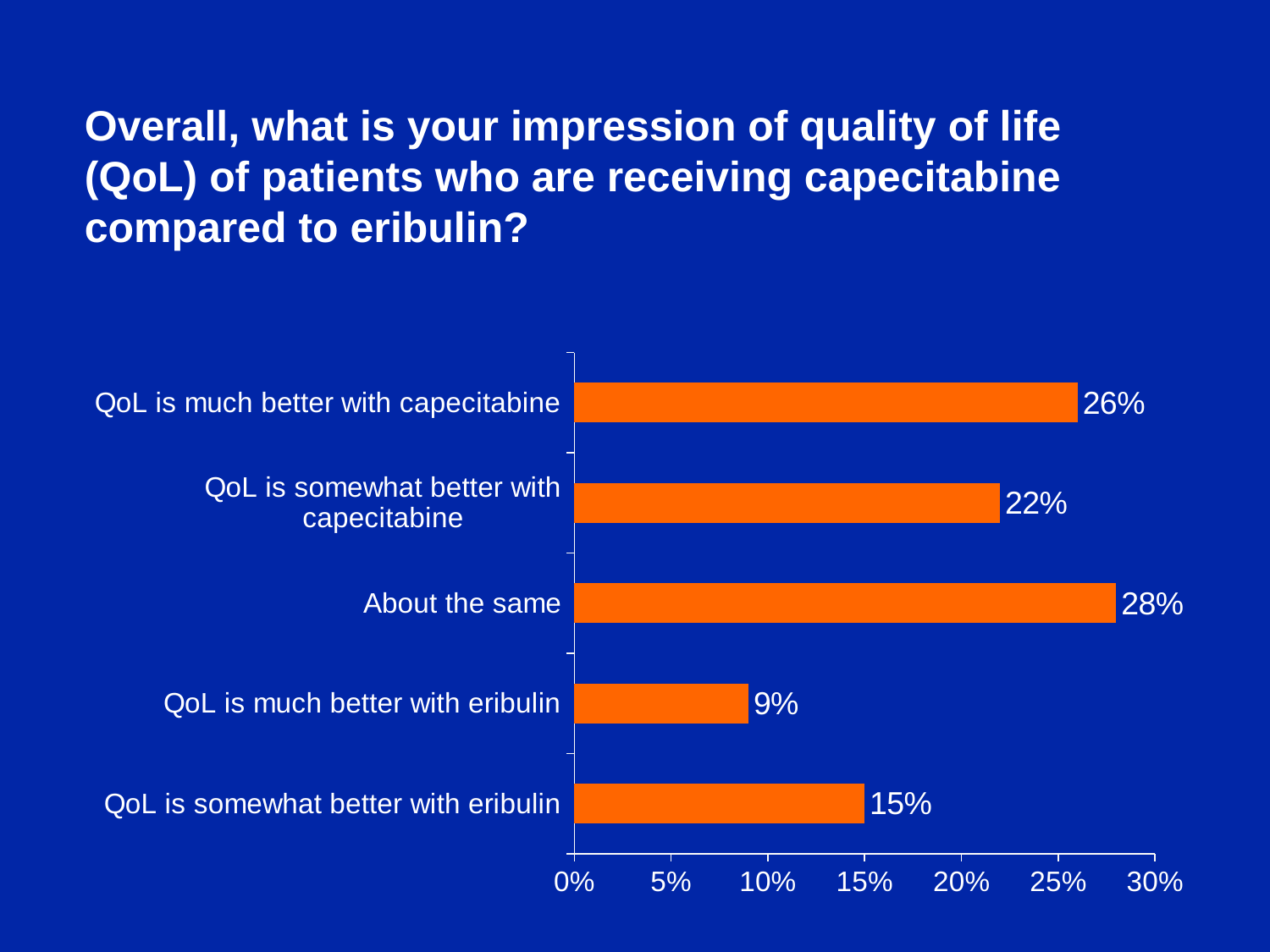
What percentage of respondents said QoL is somewhat better with capecitabine? 22% Which is larger: the percentage for 'QoL is much better with capecitabine' or for 'QoL is somewhat better with eribulin'? QoL is much better with capecitabine Which response category has the highest percentage? About the same What is the maximum value shown on the horizontal axis? 30% What percentage of respondents said QoL is much better with eribulin? 9% What is the difference in percentage points between 'About the same' and 'QoL is much better with eribulin'? 19 How many response categories are shown in the chart? 5 Which response category has the lowest percentage? QoL is much better with eribulin What type of chart is shown on the slide? Bar chart What percentage of respondents said QoL is about the same? 28% What percentage of respondents said QoL is much better with capecitabine? 26% What percentage of respondents said QoL is somewhat better with eribulin? 15%